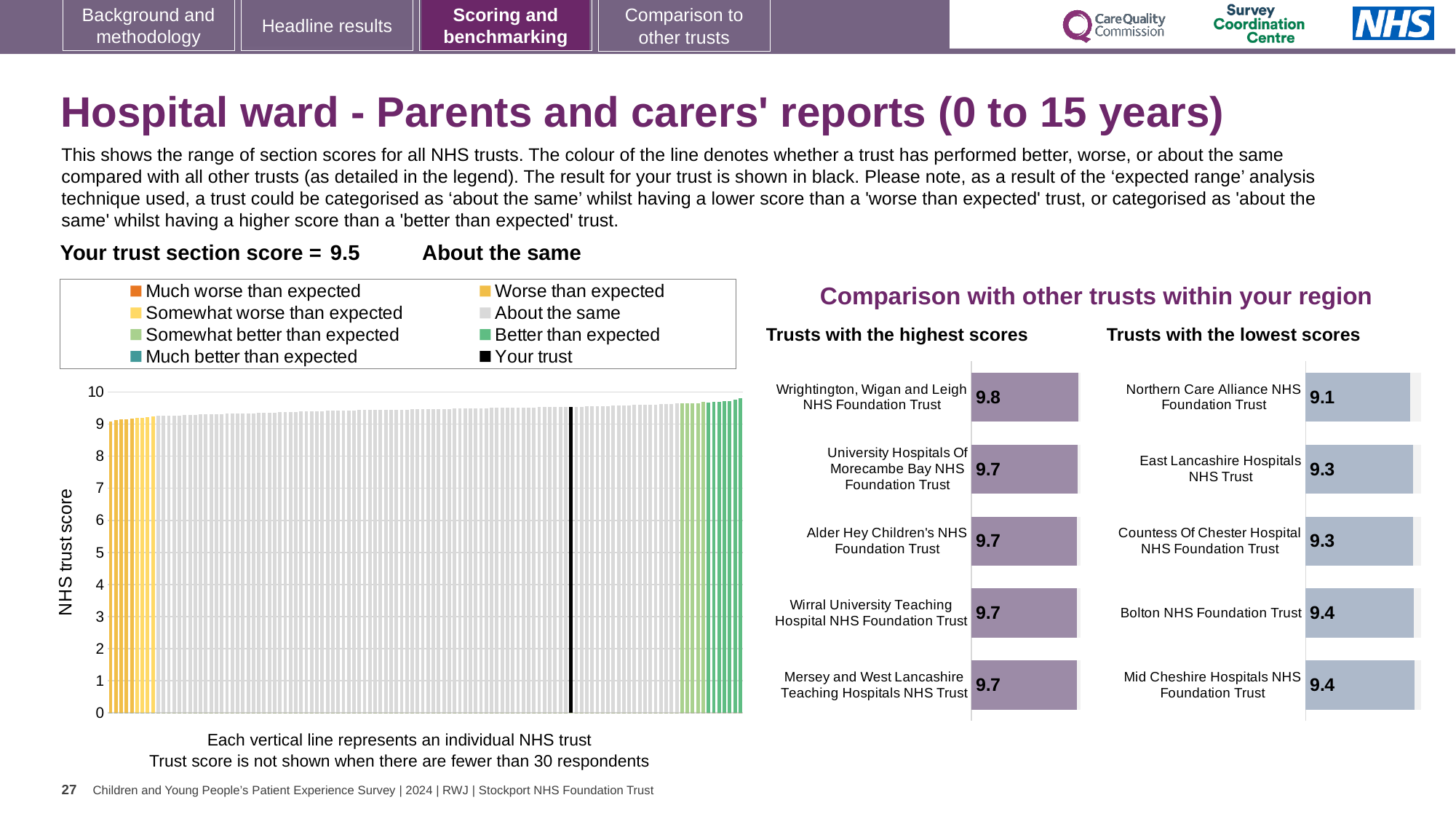
What kind of chart is the main chart on the left showing the range of section scores? bar chart In the 'Trusts with the highest scores' chart, which trust has the highest score? Wrightington, Wigan and Leigh NHS Foundation Trust How many entries does the legend above the main chart on the left list? 8 In the main chart on the left, what is the label on the vertical axis? NHS trust score In the 'Trusts with the lowest scores' chart, which trust has the lowest score? Northern Care Alliance NHS Foundation Trust In the 'Trusts with the lowest scores' chart, what is the difference between the scores for Bolton NHS Foundation Trust and Northern Care Alliance NHS Foundation Trust? 0.3 How many trusts are shown in the 'Trusts with the highest scores' chart? 5 In the main chart on the left, do the trust scores rise or fall moving from left to right along the x axis? rise In the 'Trusts with the lowest scores' chart, what is the score for East Lancashire Hospitals NHS Trust? 9.3 In the main chart on the left, is the value for your trust (the black line) greater or less than 9? greater In the 'Trusts with the highest scores' chart, what is the score for Wrightington, Wigan and Leigh NHS Foundation Trust? 9.8 In the main chart on the left, what is the section score for your trust (the black line)? 9.5